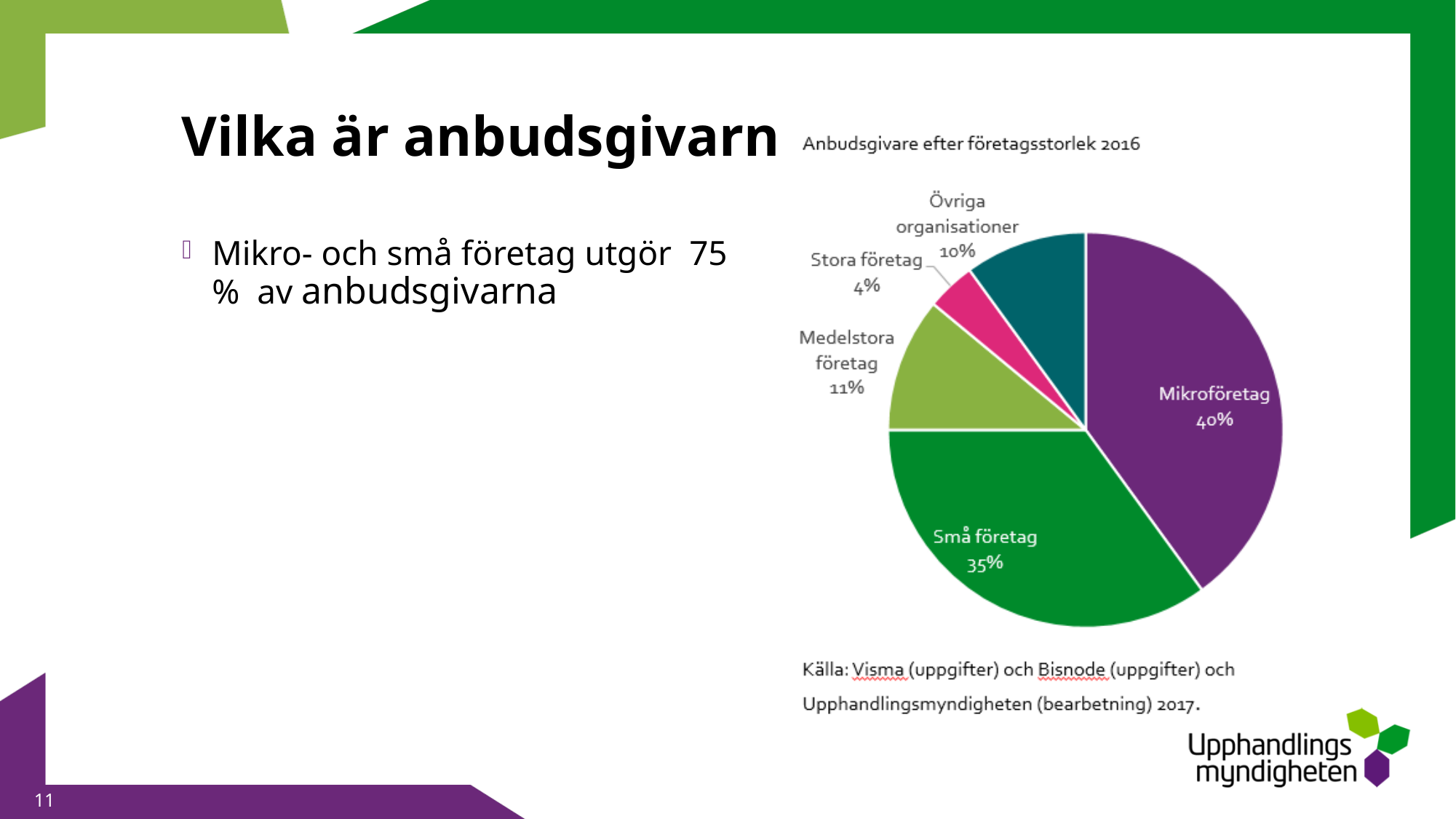
What is the value shown for Medelstora företag? 11% How many categories are shown in the pie chart? 5 Which is larger, Medelstora företag or Övriga organisationer? Medelstora företag What share of the pie does Mikroföretag represent? 40% What is the value shown for Övriga organisationer? 10% What share of the pie does Små företag represent? 35% What is the value shown for Stora företag? 4% What is the title of the chart? Anbudsgivare efter företagsstorlek 2016 Which category has the smallest slice of the pie? Stora företag What kind of chart is shown on the slide? Pie chart Which category has the largest slice of the pie? Mikroföretag What is the difference in percentage points between Mikroföretag and Små företag? 5